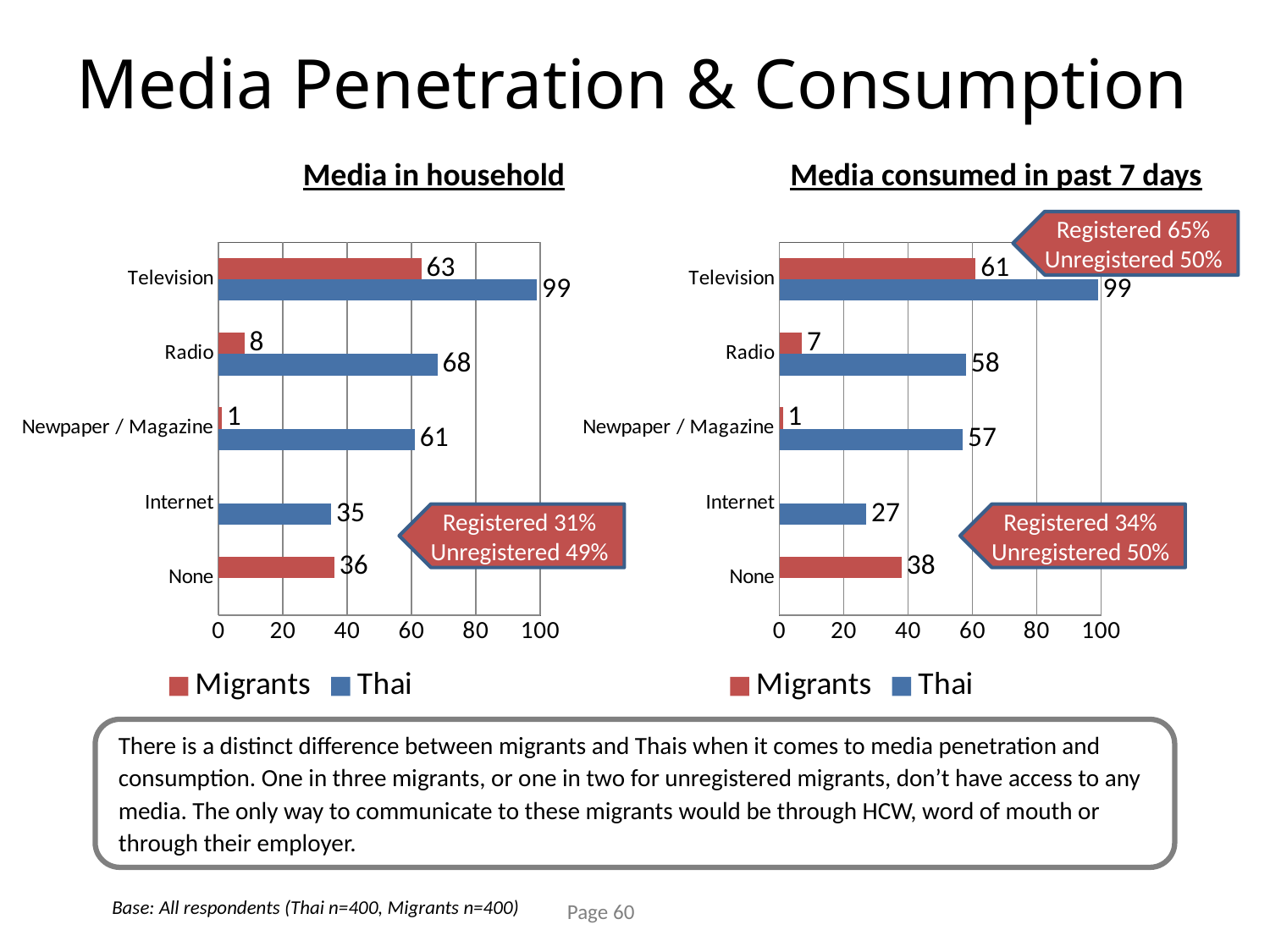
What type of chart is the 'Media in household' chart? Bar chart In the 'Media consumed in past 7 days' chart, what is the value for Migrants for None? 38 In the 'Media consumed in past 7 days' chart, which category has the lowest value for Migrants? Newpaper / Magazine In the 'Media in household' chart, what is the value for Migrants for Radio? 8 In the 'Media in household' chart, how many categories are shown on the vertical axis? 5 In the 'Media in household' chart, what is the difference between the Thai and Migrants values for Television? 36 In the 'Media consumed in past 7 days' chart, which colour represents Migrants? Red In the 'Media consumed in past 7 days' chart, what is the value for Thai for Internet? 27 In the 'Media consumed in past 7 days' chart, how many series does the legend list? 2 In the 'Media in household' chart, which category has the highest value for Thai? Television In the 'Media consumed in past 7 days' chart, which is larger for Radio: the Thai value or the Migrants value? Thai In the 'Media in household' chart, what is the value for Thai for Television? 99